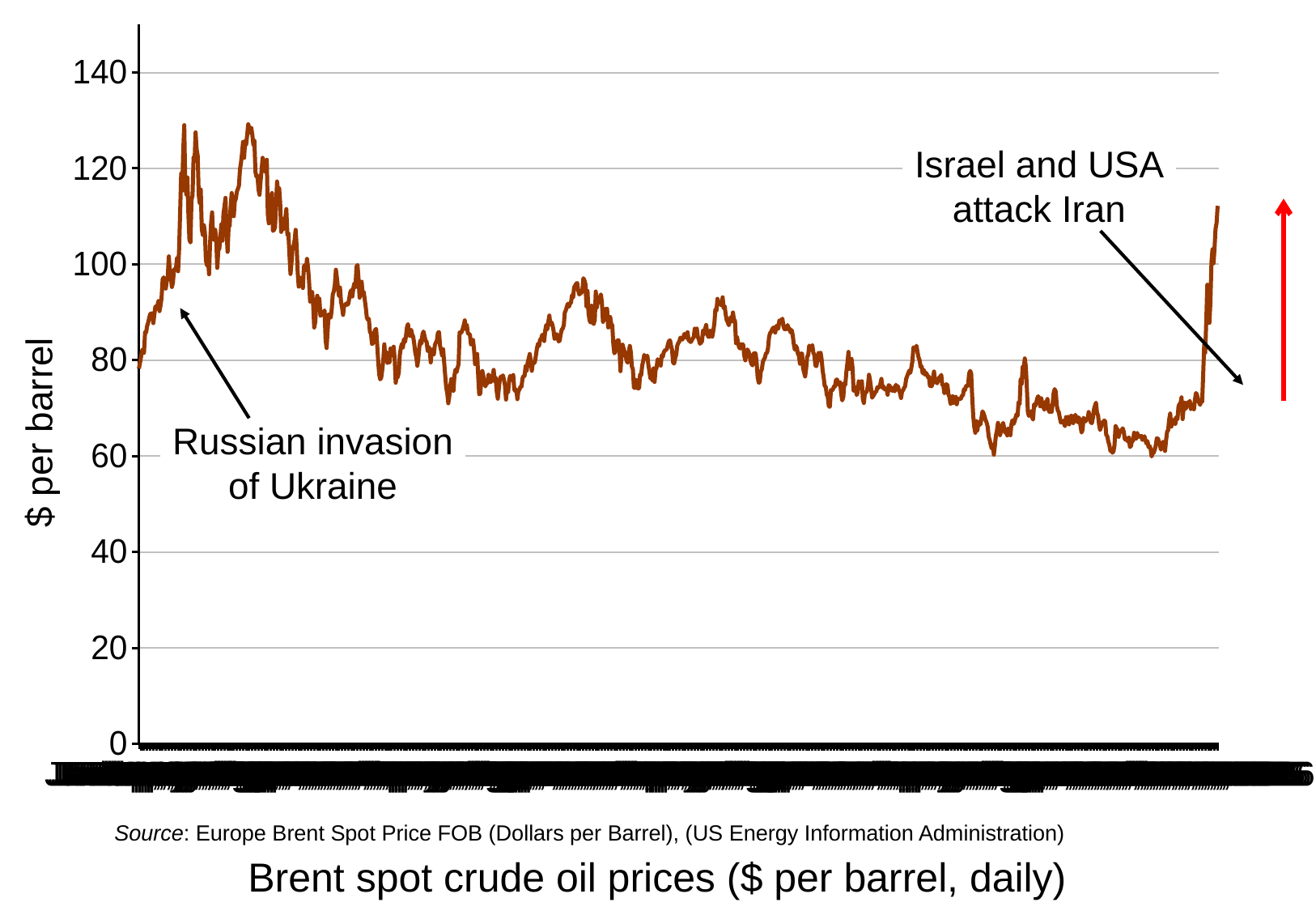
What kind of chart is shown on the slide? line chart What is the title of the chart? Brent spot crude oil prices ($ per barrel, daily) Does the line rise or fall at the far right end of the chart, after the point annotated 'Israel and USA attack Iran'? rise What is the label on the vertical axis of the chart? $ per barrel Is the value at the point annotated 'Israel and USA attack Iran' greater or less than 100? less Is the highest value reached by the line greater or less than 120? greater Is the lowest value reached by the line greater or less than 80? less Does the line generally rise or fall from its peaks near the left of the chart to the point annotated 'Israel and USA attack Iran'? fall